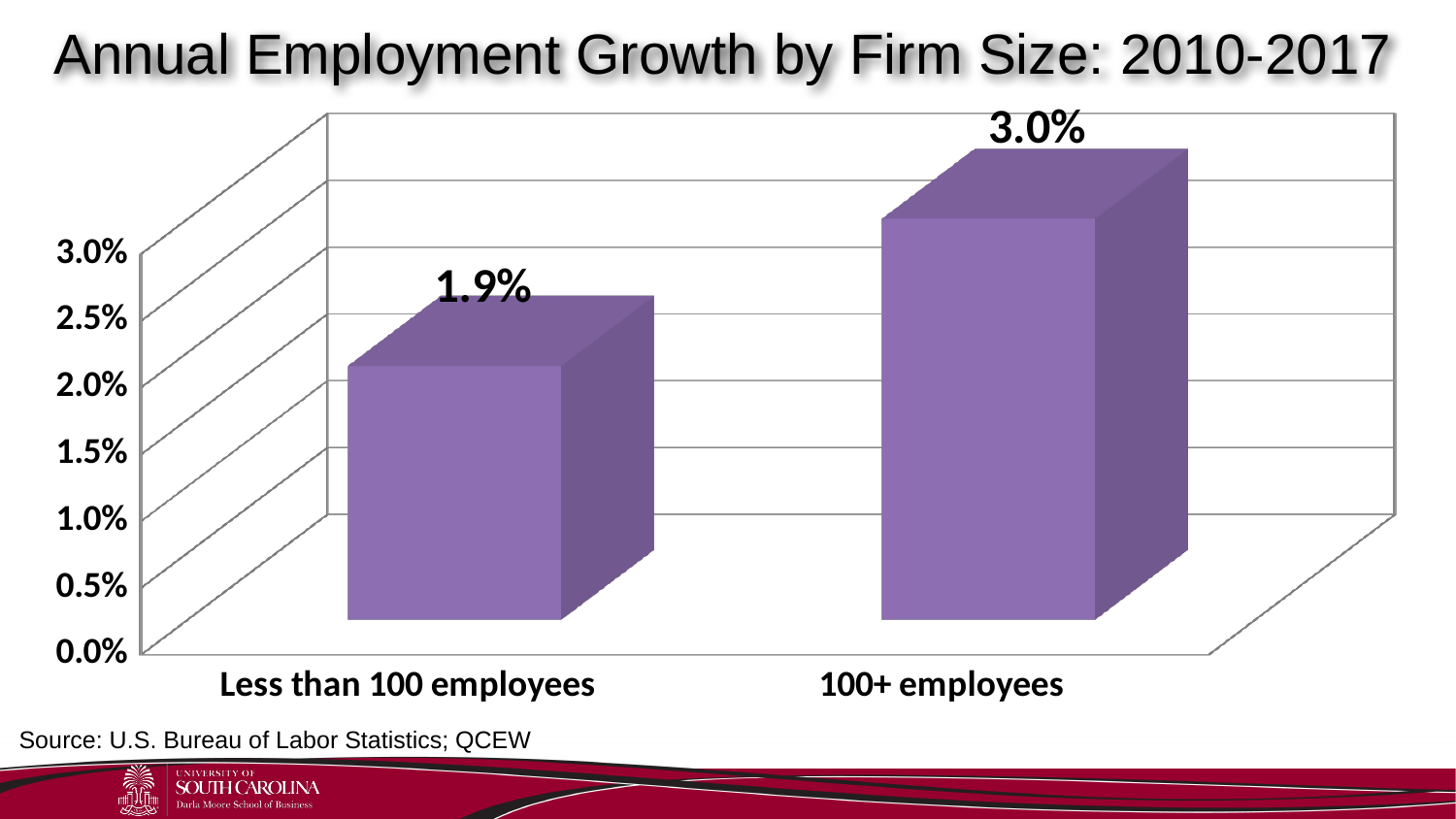
Which firm size category has the lowest annual employment growth? Less than 100 employees How many firm size categories are shown in the chart? 2 What is the annual employment growth for firms with 100+ employees? 3.0% Is the value for firms with 100+ employees greater or less than 2.5%? greater What is the annual employment growth for firms with less than 100 employees? 1.9% Which firm size category has the highest annual employment growth? 100+ employees What source is cited for the chart data? U.S. Bureau of Labor Statistics; QCEW What kind of chart is shown on the slide? Bar chart Is the value for firms with less than 100 employees greater or less than 2.0%? less Which is larger: the growth for firms with less than 100 employees or for firms with 100+ employees? 100+ employees What is the difference in annual employment growth between firms with 100+ employees and firms with less than 100 employees? 1.1% What is the title of the chart? Annual Employment Growth by Firm Size: 2010-2017